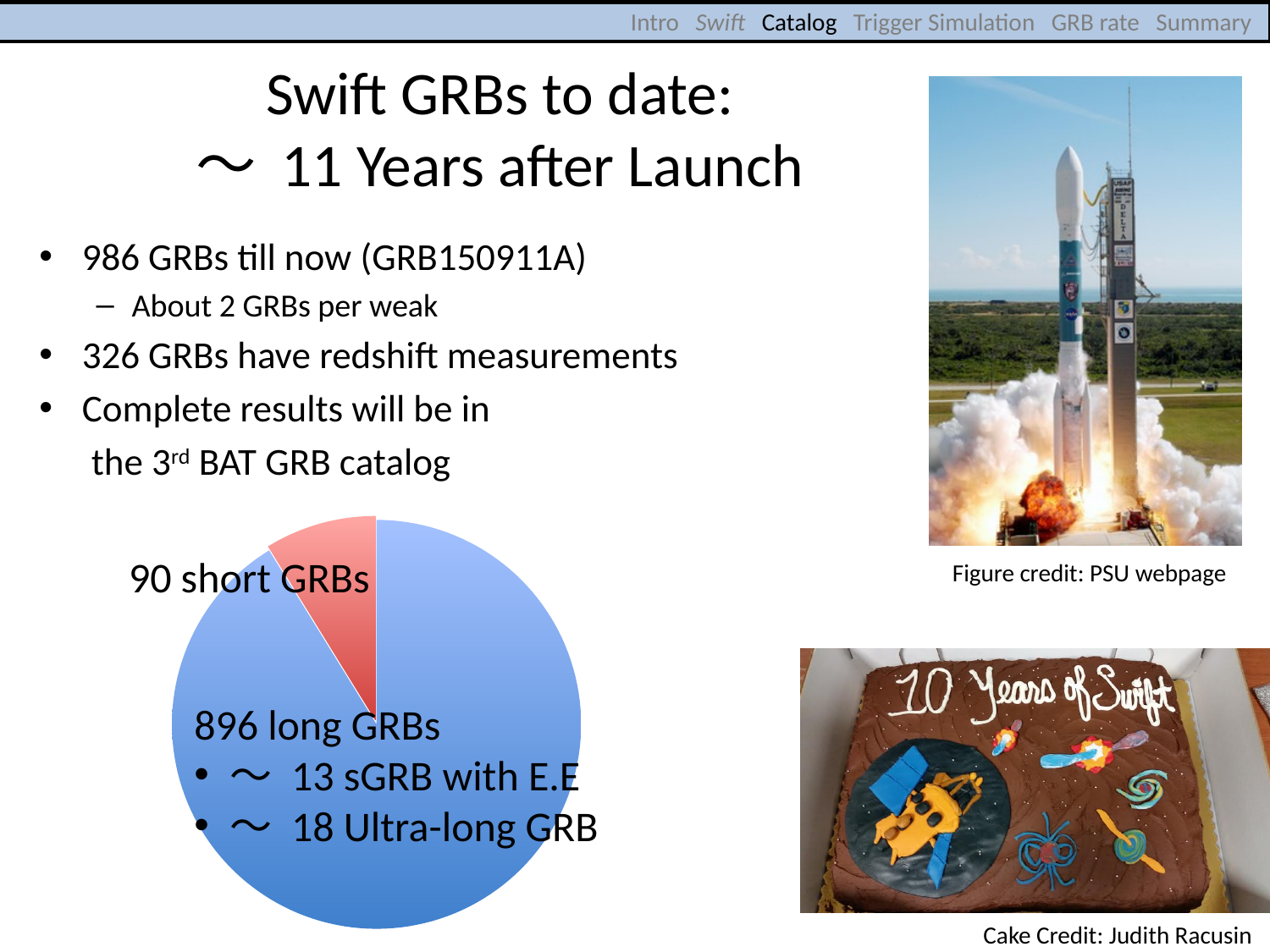
Which category has the largest slice in the pie chart? long GRBs How many long GRBs does the pie chart label show? 896 What colour is the short GRBs slice in the pie chart? red Which is larger in the pie chart, the number of short GRBs or the number of long GRBs? long GRBs How many slices does the pie chart have? 2 What kind of chart is shown on the slide? pie chart How many short GRBs does the pie chart label show? 90 What is the difference between the number of long GRBs and short GRBs in the pie chart? 806 What colour is the long GRBs slice in the pie chart? blue Which category has the smallest slice in the pie chart? short GRBs